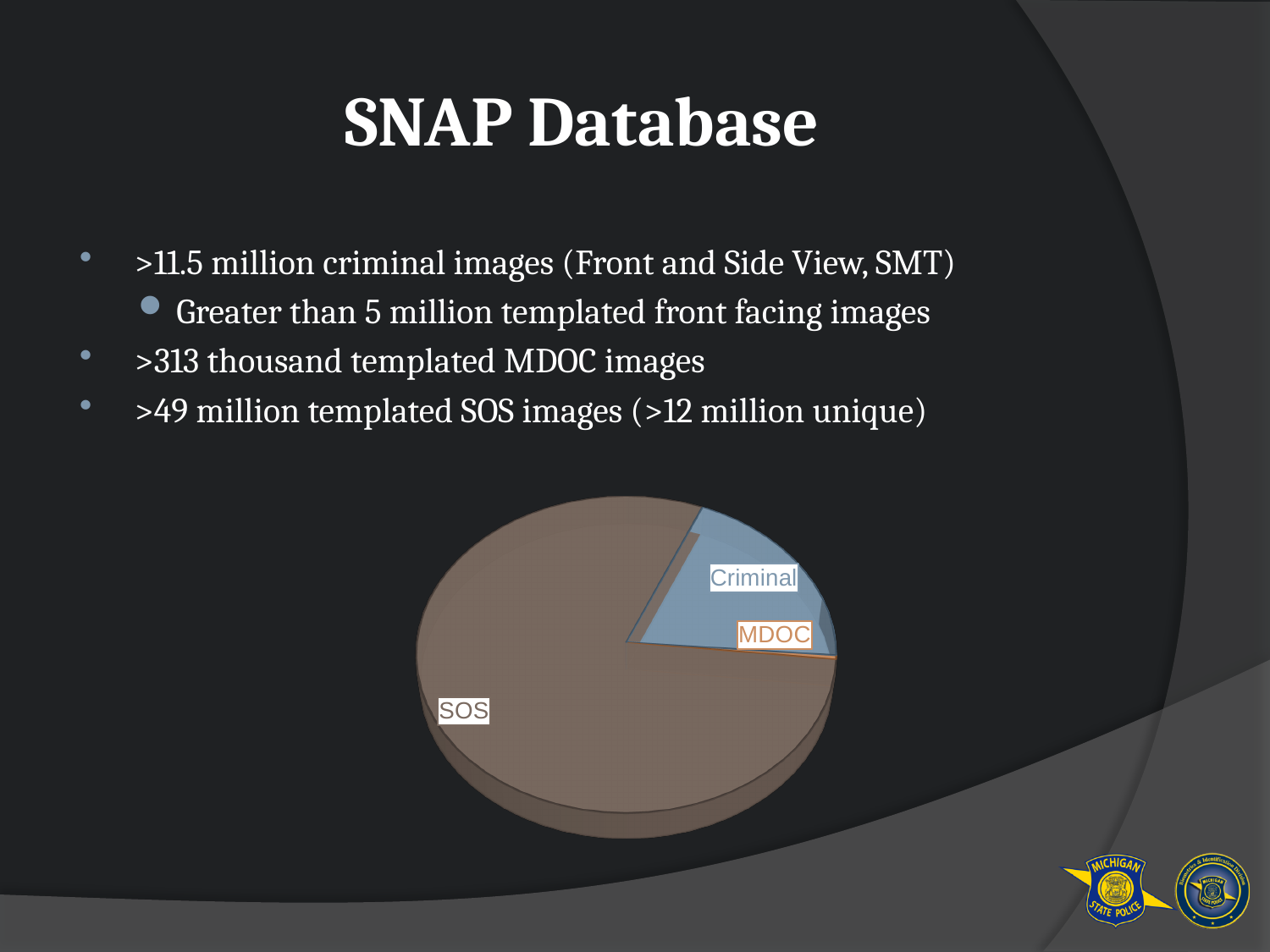
Which slice of the pie chart is the smallest? MDOC Which slice of the pie chart is larger, Criminal or SOS? SOS What are the labels of the three slices in the pie chart? SOS, Criminal, MDOC What colour is the Criminal slice in the pie chart? blue What kind of chart is shown on the slide? pie chart Which slice of the pie chart is larger, Criminal or MDOC? Criminal Which slice of the pie chart is the largest? SOS How many slices does the pie chart have? 3 Does the SOS slice take up more or less than half of the pie chart? more